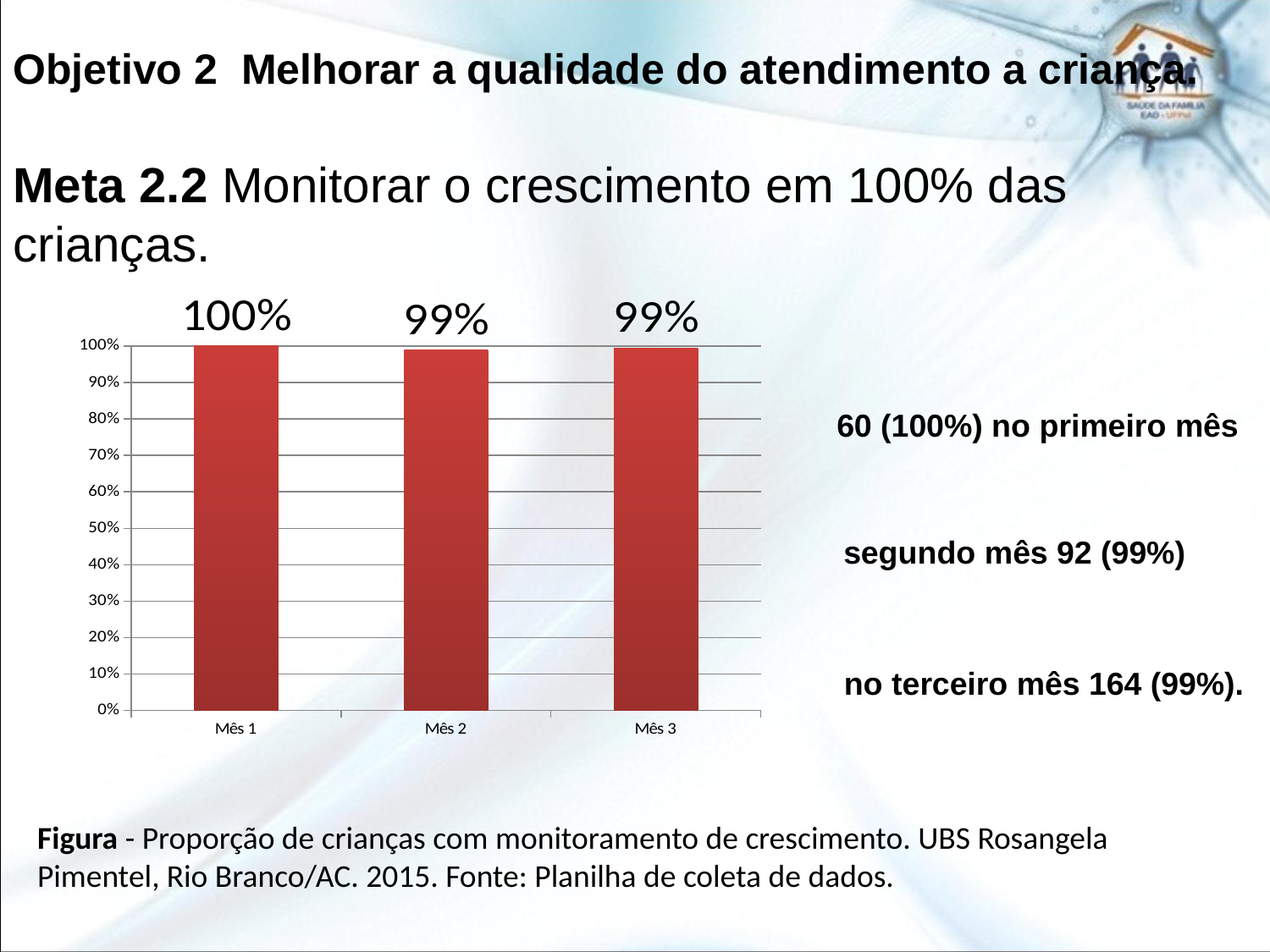
Is the value for Mês 2 greater or less than 90%? greater What is the value for Mês 2? 99% What is the difference between the values for Mês 1 and Mês 2? 1% Does the value rise or fall from Mês 1 to Mês 2? fall Which is larger, the value for Mês 1 or the value for Mês 3? Mês 1 What is the value for Mês 1? 100% How many months are shown on the x axis? 3 What kind of chart is shown on the slide? bar chart What is the highest tick shown on the y axis? 100% What is the value for Mês 3? 99% Which month has the highest value? Mês 1 Do the values for Mês 2 and Mês 3 differ? No, both are 99%